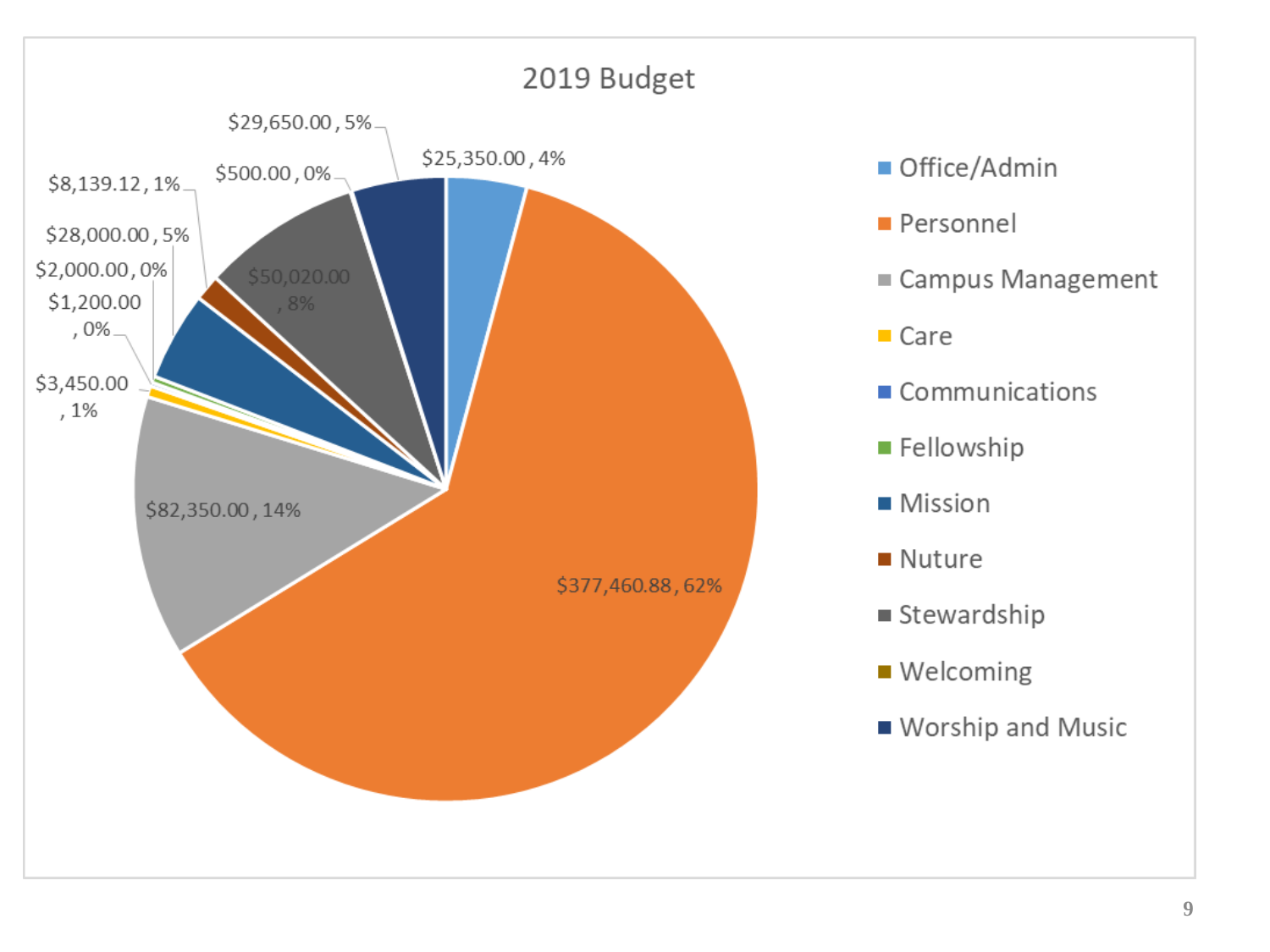
Which category has the largest slice of the pie? Personnel What is the title of the chart? 2019 Budget What is the budget value for Personnel? $377,460.88 What share of the 2019 Budget does Personnel represent? 62% What is the budget value for Office/Admin? $25,350.00 What kind of chart is shown on the slide? pie chart What share of the pie does Campus Management represent? 14% What is the budget value for Campus Management? $82,350.00 What is the difference between the Personnel value and the Campus Management value? $295,110.88 Which is larger, the Campus Management slice or the Stewardship slice? Campus Management How many categories does the legend list? 11 What is the budget value for Stewardship? $50,020.00